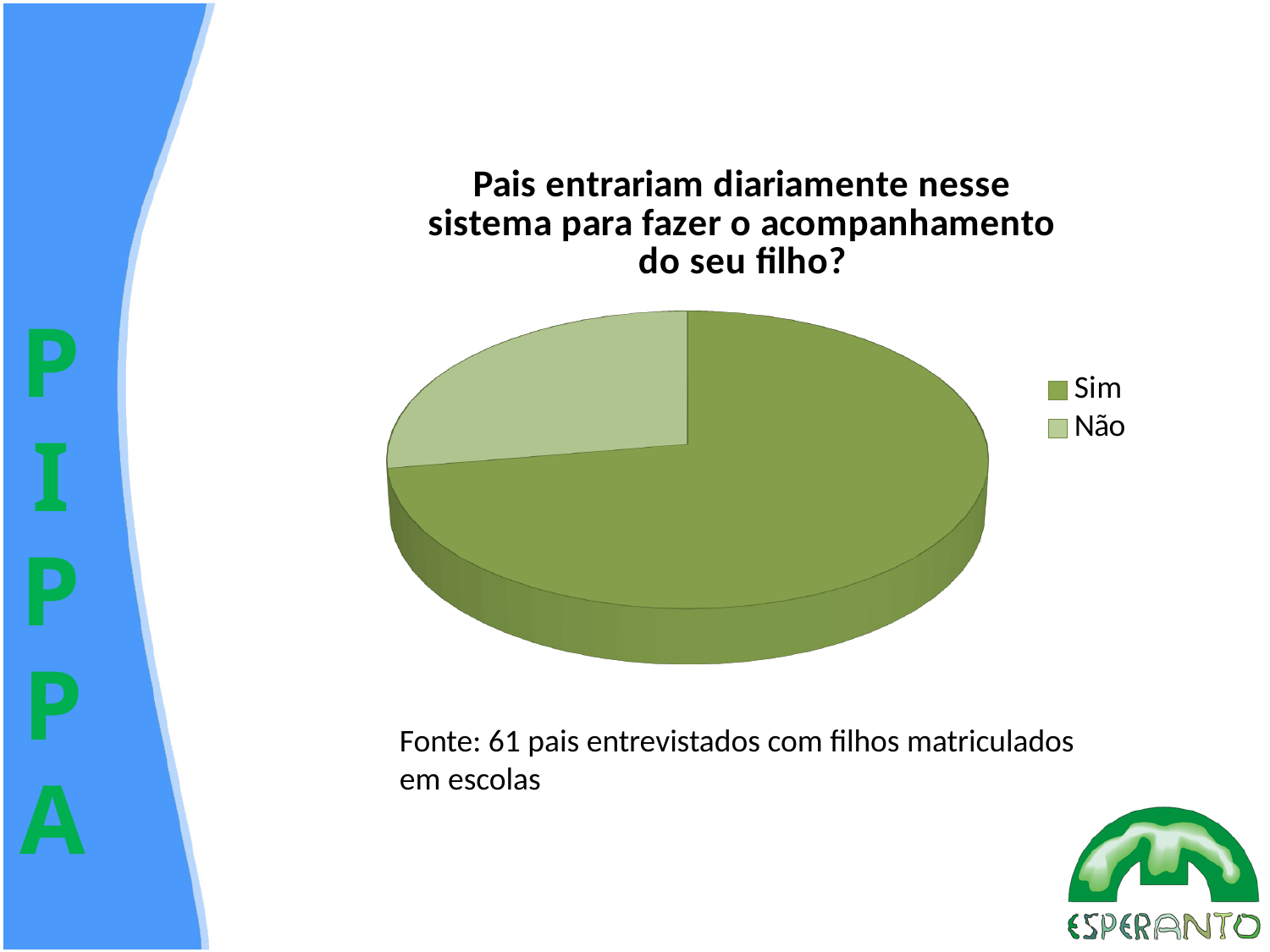
What kind of chart is shown on the slide? pie chart What is the title of the pie chart? Pais entrariam diariamente nesse sistema para fazer o acompanhamento do seu filho? Which category has the smallest slice of the pie chart? Não Which legend entry is shown in the lighter green colour? Não How many slices does the pie chart have? 2 How many entries does the legend of the pie chart list? 2 Which slice is larger in the pie chart, Sim or Não? Sim Which category has the largest slice of the pie chart? Sim